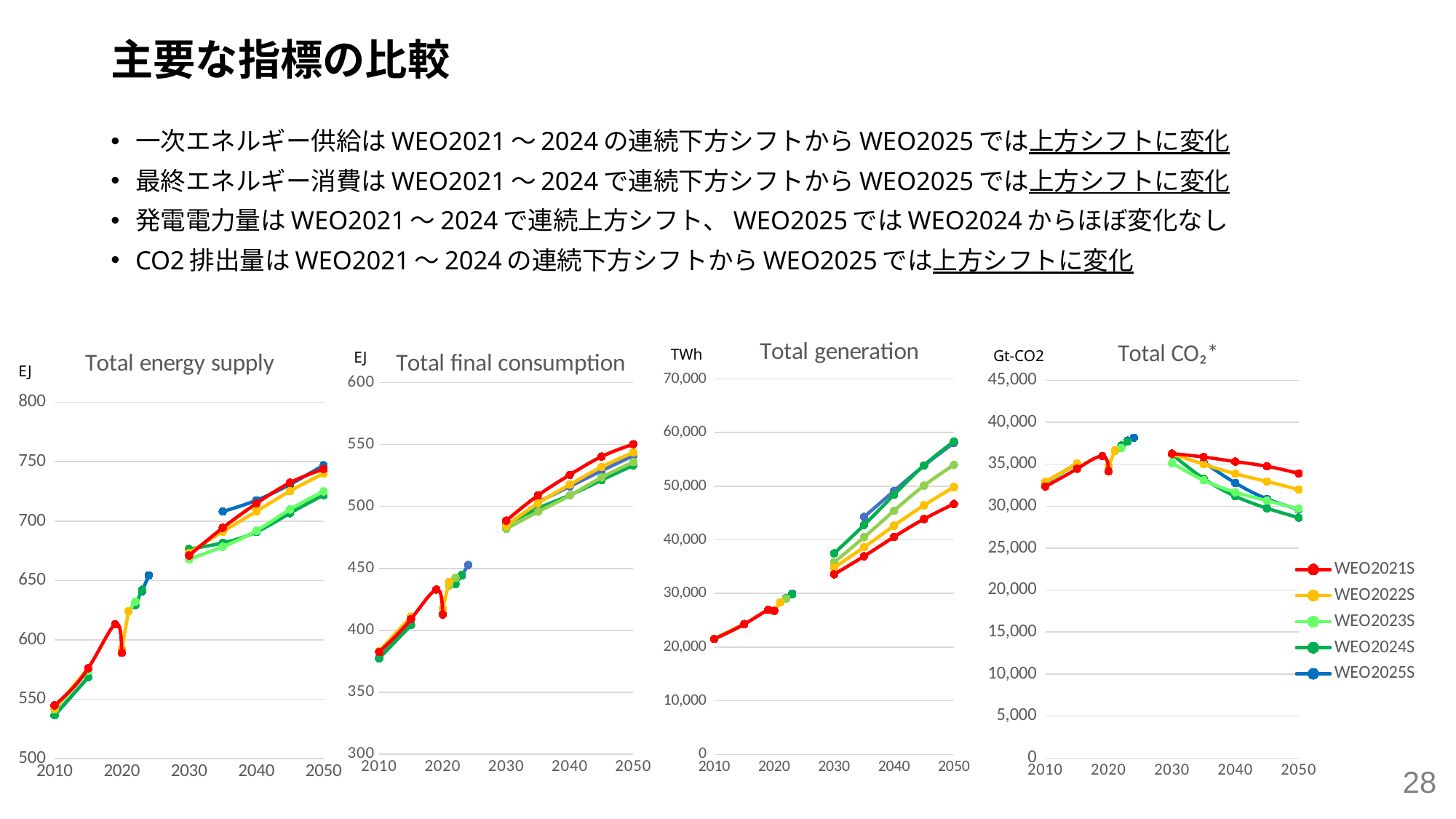
In the 'Total generation' chart, do the series rise or fall from 2030 to 2050? rise In the 'Total CO₂*' chart, does the WEO2021S line rise or fall from 2030 to 2050? fall In the 'Total CO₂*' chart, is the value for WEO2024S in 2050 greater or less than 30,000? less How many charts are shown on the slide? 4 In the 'Total generation' chart, is the value for WEO2024S in 2050 greater or less than 50,000? greater In the 'Total generation' chart, which series has the lowest value in 2050? WEO2021S How many series does the legend on the slide list? 5 What kind of chart is the 'Total energy supply' chart? line chart What unit is shown on the vertical axis of the 'Total generation' chart? TWh In the 'Total energy supply' chart, is the value for WEO2021S in 2050 greater or less than 700? greater